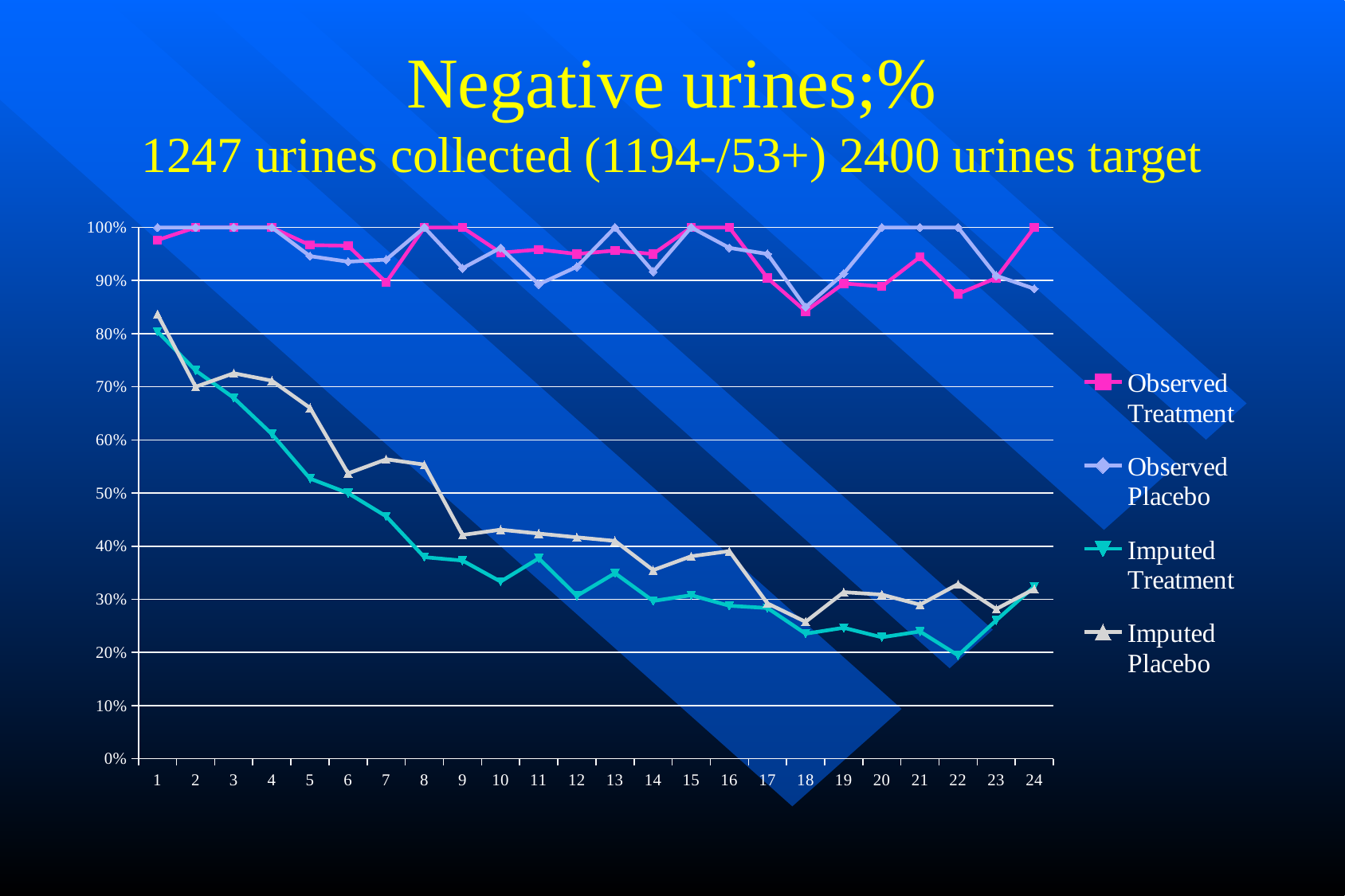
At point 22, which is higher: Imputed Placebo or Imputed Treatment? Imputed Placebo What kind of chart is shown on the slide? line chart Does the Imputed Treatment series generally rise or fall from point 1 to point 24? fall Is the value for Observed Treatment at point 18 greater or less than 90%? less How many series does the legend list? 4 How many points are there along the x axis? 24 What is the value of Observed Treatment at point 24? 100% What is the value of Observed Placebo at point 1? 100% Is the value for Imputed Treatment at point 10 greater or less than 30%? greater Is the value for Imputed Placebo at point 1 greater or less than 80%? greater What is the main title of the chart slide? Negative urines;% At point 7, which is higher: Observed Placebo or Observed Treatment? Observed Placebo